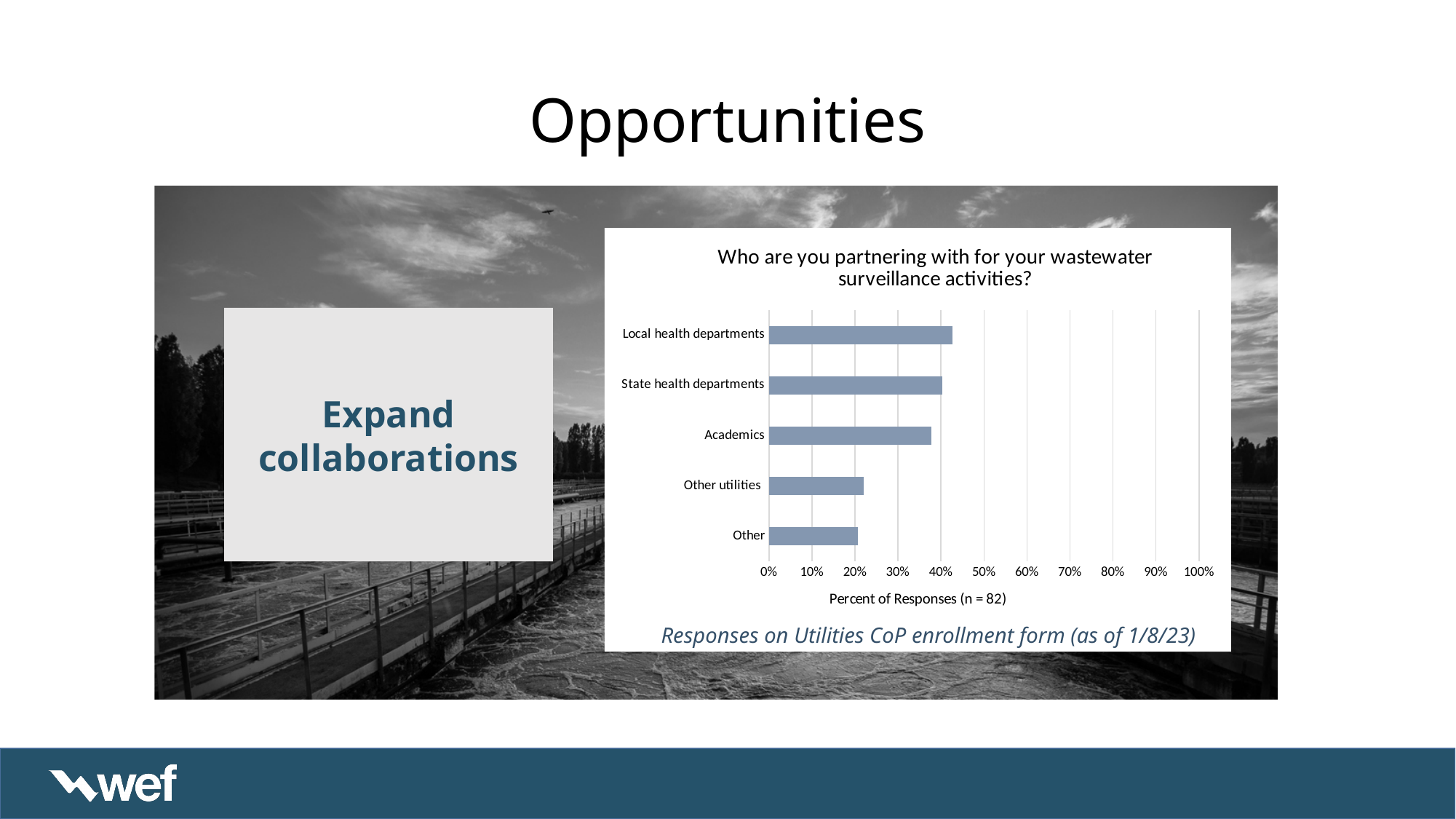
Which has a higher percent of responses, Academics or Other utilities? Academics Which category has the highest percent of responses? Local health departments What is the label of the horizontal axis? Percent of Responses (n = 82) Which has a higher percent of responses, Other or State health departments? State health departments Is the value for Other utilities greater or less than 30%? less Is the value for Other greater or less than 30%? less Is the value for Academics greater or less than 40%? less What is the title of the chart? Who are you partnering with for your wastewater surveillance activities? Do the bar values increase or decrease going from the top category to the bottom category? decrease How many categories are plotted in the chart? 5 What kind of chart is shown on the slide? Bar chart